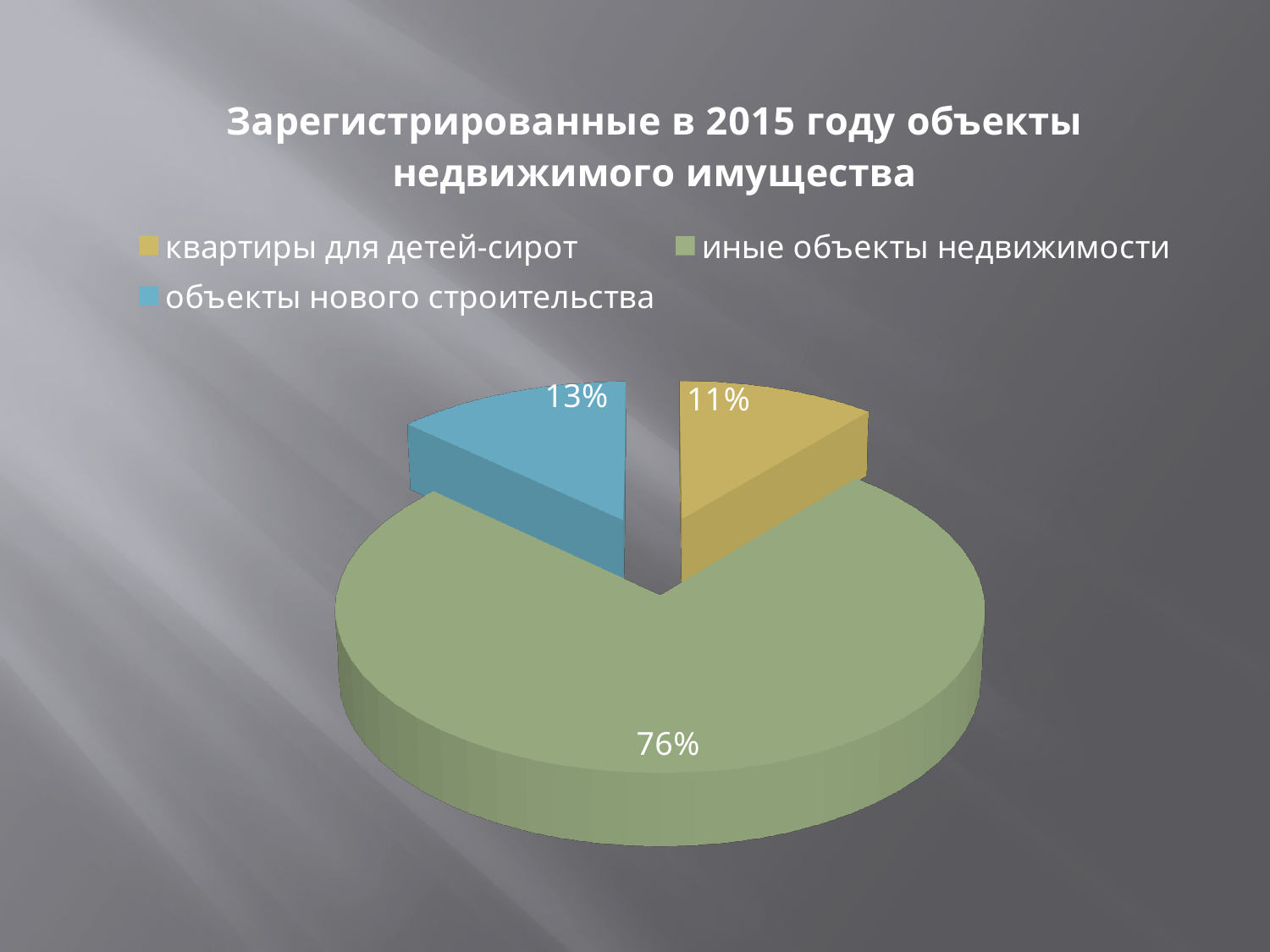
What is the difference in percentage points between 'иные объекты недвижимости' and 'объекты нового строительства'? 63 Which category has the largest slice of the pie? иные объекты недвижимости What kind of chart is shown on the slide? pie chart What share of the pie is 'иные объекты недвижимости'? 76% What share of the pie is 'объекты нового строительства'? 13% What is the title of the chart? Зарегистрированные в 2015 году объекты недвижимого имущества How many categories does the pie chart have? 3 Which is larger: the share for 'объекты нового строительства' or the share for 'квартиры для детей-сирот'? объекты нового строительства What share of the pie is 'квартиры для детей-сирот'? 11% How many entries does the legend list? 3 Which category has the smallest slice of the pie? квартиры для детей-сирот What colour is the slice for 'объекты нового строительства'? blue